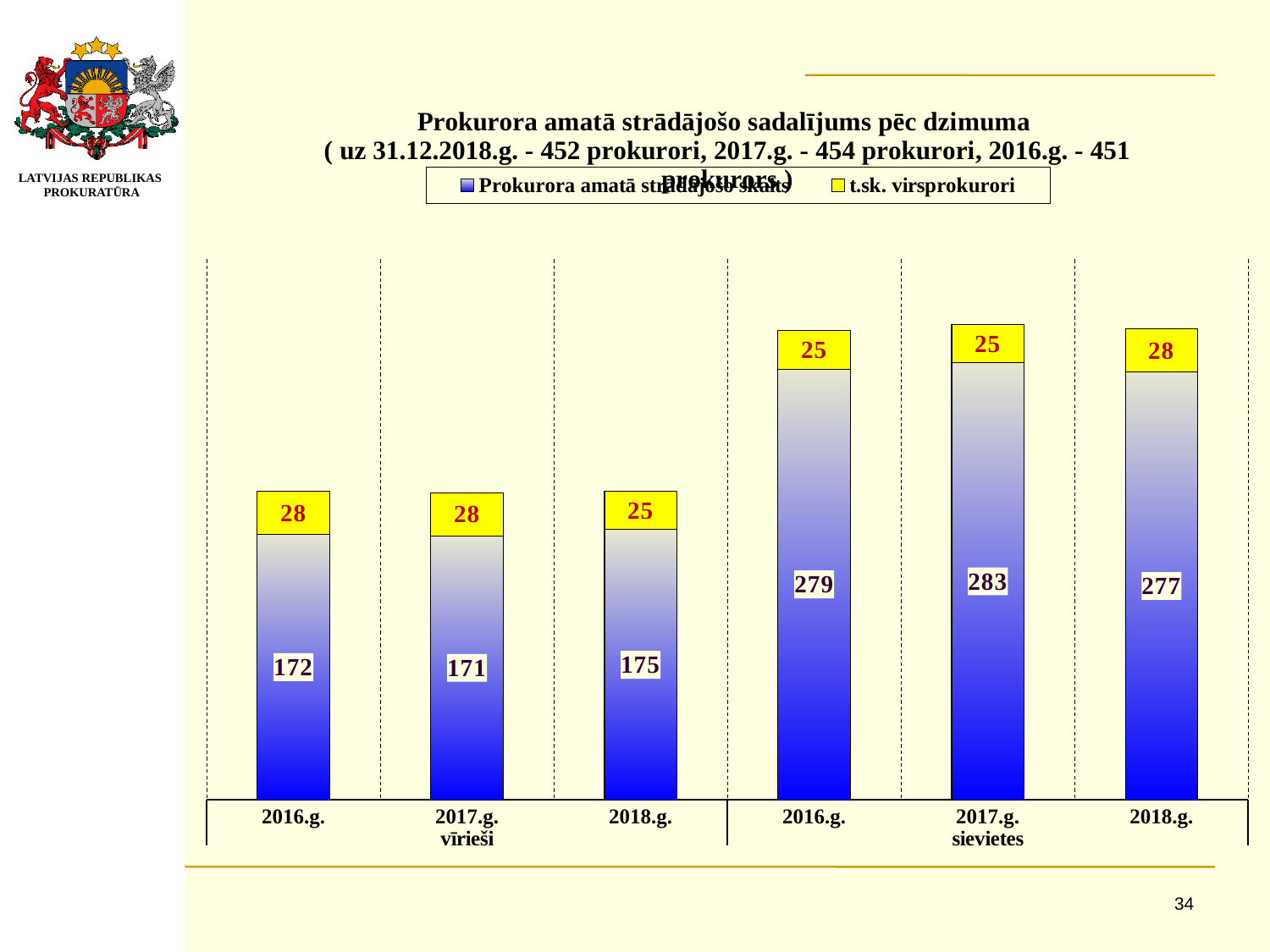
What is the value of 'Prokurora amatā strādājošo skaits' for vīrieši in 2016.g.? 172 What is the value of 't.sk. virsprokurori' for sievietes in 2018.g.? 28 How many bars are plotted in the chart? 6 Which category has the highest value of 'Prokurora amatā strādājošo skaits'? sievietes 2017.g. What kind of chart is shown on the slide? bar chart What is the difference between the 'Prokurora amatā strādājošo skaits' values for sievietes in 2016.g. and vīrieši in 2016.g.? 107 What is the value of 't.sk. virsprokurori' for vīrieši in 2018.g.? 25 Which is larger: 'Prokurora amatā strādājošo skaits' for vīrieši in 2018.g. or for vīrieši in 2017.g.? vīrieši 2018.g. Which category has the lowest value of 'Prokurora amatā strādājošo skaits'? vīrieši 2017.g. How many series does the legend list? 2 What is the value of 'Prokurora amatā strādājošo skaits' for sievietes in 2017.g.? 283 Which colour represents 't.sk. virsprokurori' in the chart? yellow